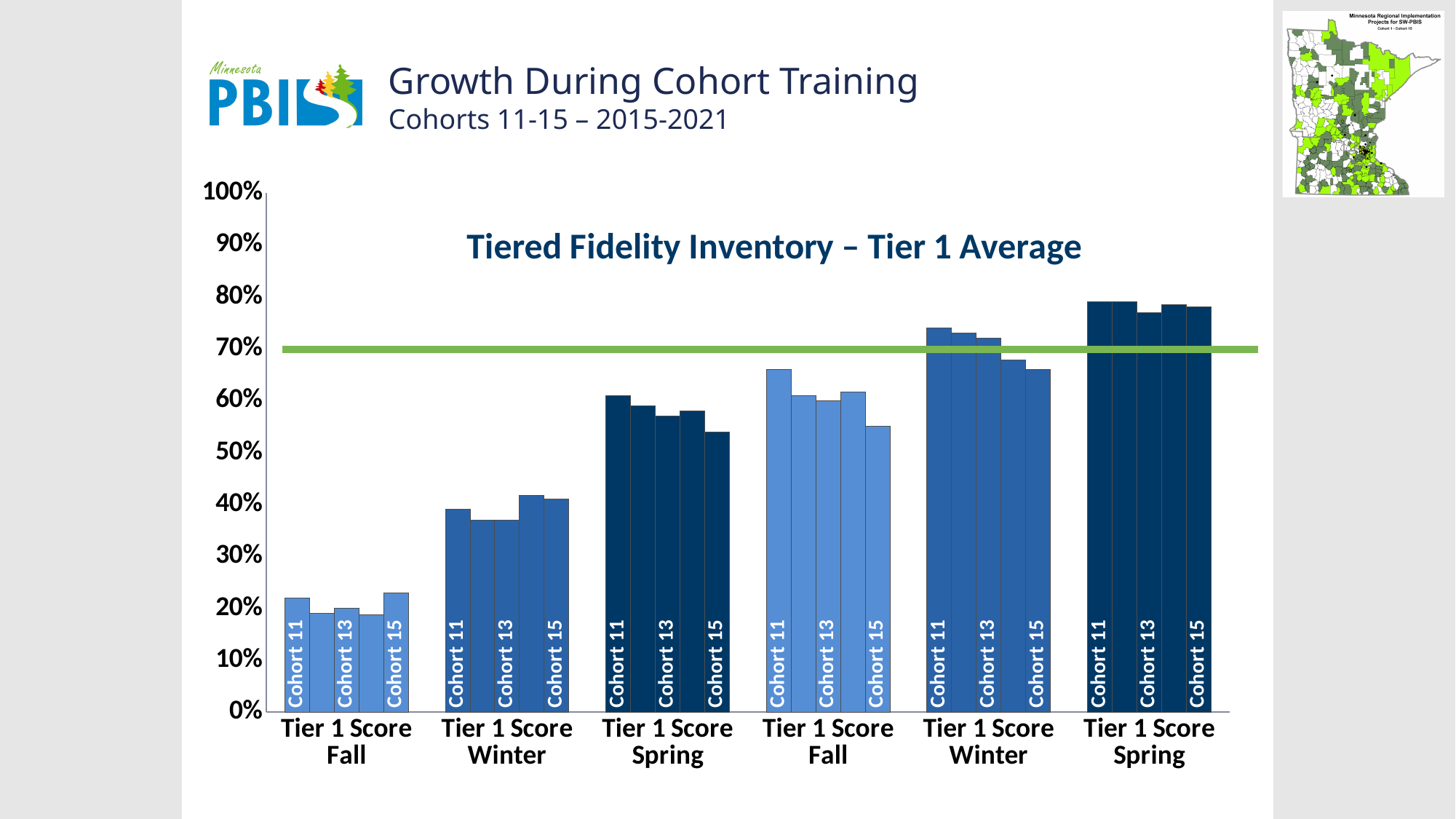
In the first 'Tier 1 Score Fall' group (leftmost), is the value for Cohort 11 greater or less than 30%? less How many bars are in each category group of the chart? 5 At what level on the y axis is the green horizontal line drawn? 70% In the second 'Tier 1 Score Winter' group (fifth from left), is the value for Cohort 15 greater or less than 70%? less In the rightmost 'Tier 1 Score Spring' group, is the value for Cohort 11 greater or less than 70%? greater Moving from the leftmost group to the rightmost group along the x axis, do the Cohort 11 values generally rise or fall? rise Which category group on the x axis has the tallest bars? the rightmost Tier 1 Score Spring group What is the title printed inside the chart? Tiered Fidelity Inventory – Tier 1 Average How many category groups are labelled along the x axis of the chart? 6 What kind of chart is shown on the slide? bar chart